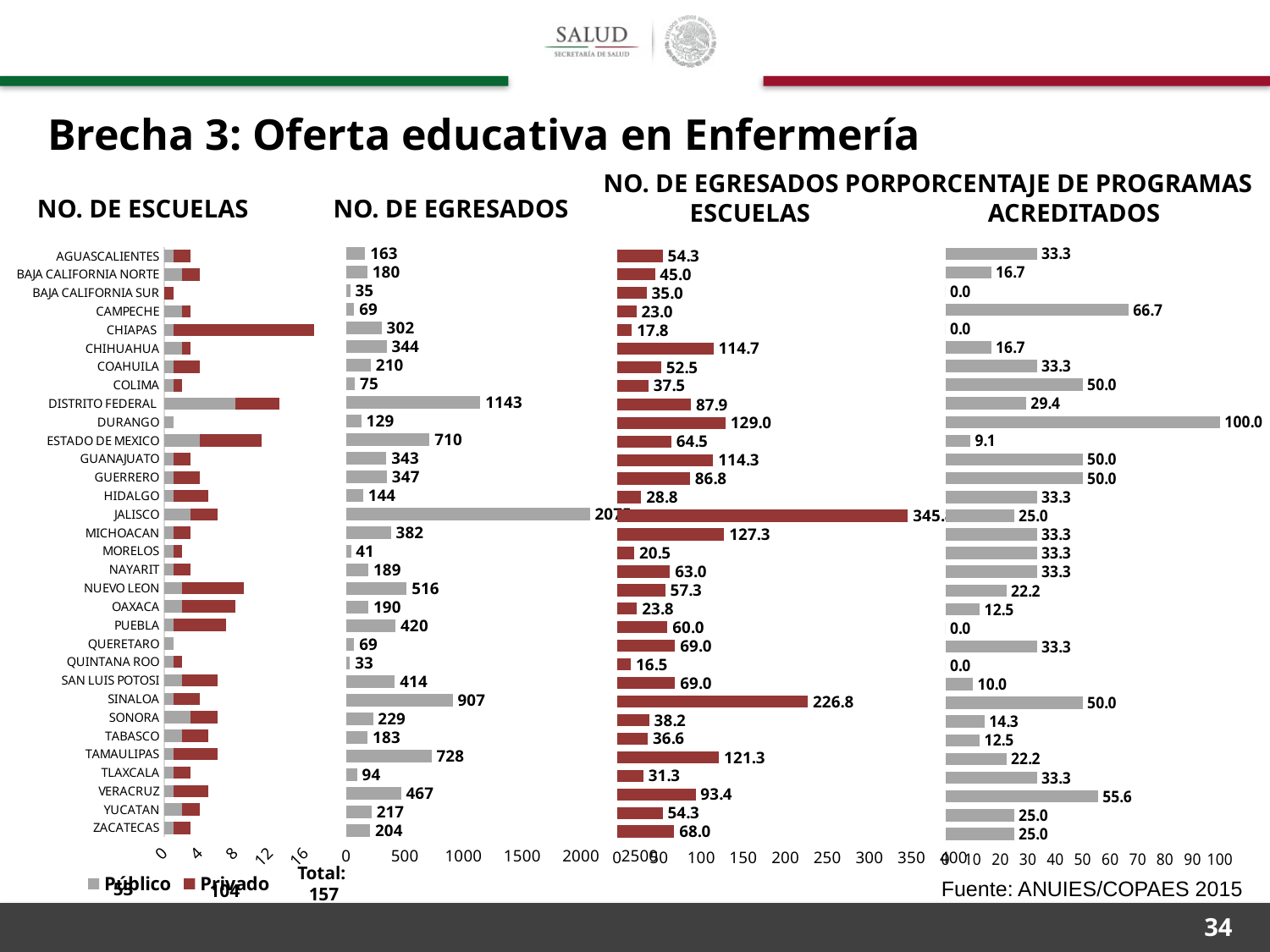
In the PORCENTAJE DE PROGRAMAS ACREDITADOS chart, which state has the highest value? DURANGO In the NO. DE EGRESADOS chart, what is the value for DISTRITO FEDERAL? 1143 In the NO. DE EGRESADOS chart, which is larger, TAMAULIPAS or ESTADO DE MEXICO? TAMAULIPAS In the PORCENTAJE DE PROGRAMAS ACREDITADOS chart, what is the value for CAMPECHE? 66.7 In the NO. DE EGRESADOS POR ESCUELAS chart, what is the value for SINALOA? 226.8 In the NO. DE EGRESADOS POR ESCUELAS chart, which state has the lowest value? QUINTANA ROO In the NO. DE EGRESADOS chart, which state has the lowest value? QUINTANA ROO In the NO. DE ESCUELAS chart, is the total value for CHIAPAS greater or less than 12? greater In the NO. DE EGRESADOS chart, which state has the highest value? JALISCO How many series does the legend of the NO. DE ESCUELAS chart list? 2 In the NO. DE EGRESADOS chart, what is the difference between DISTRITO FEDERAL and SINALOA? 236 How many states are shown in the NO. DE EGRESADOS chart? 32